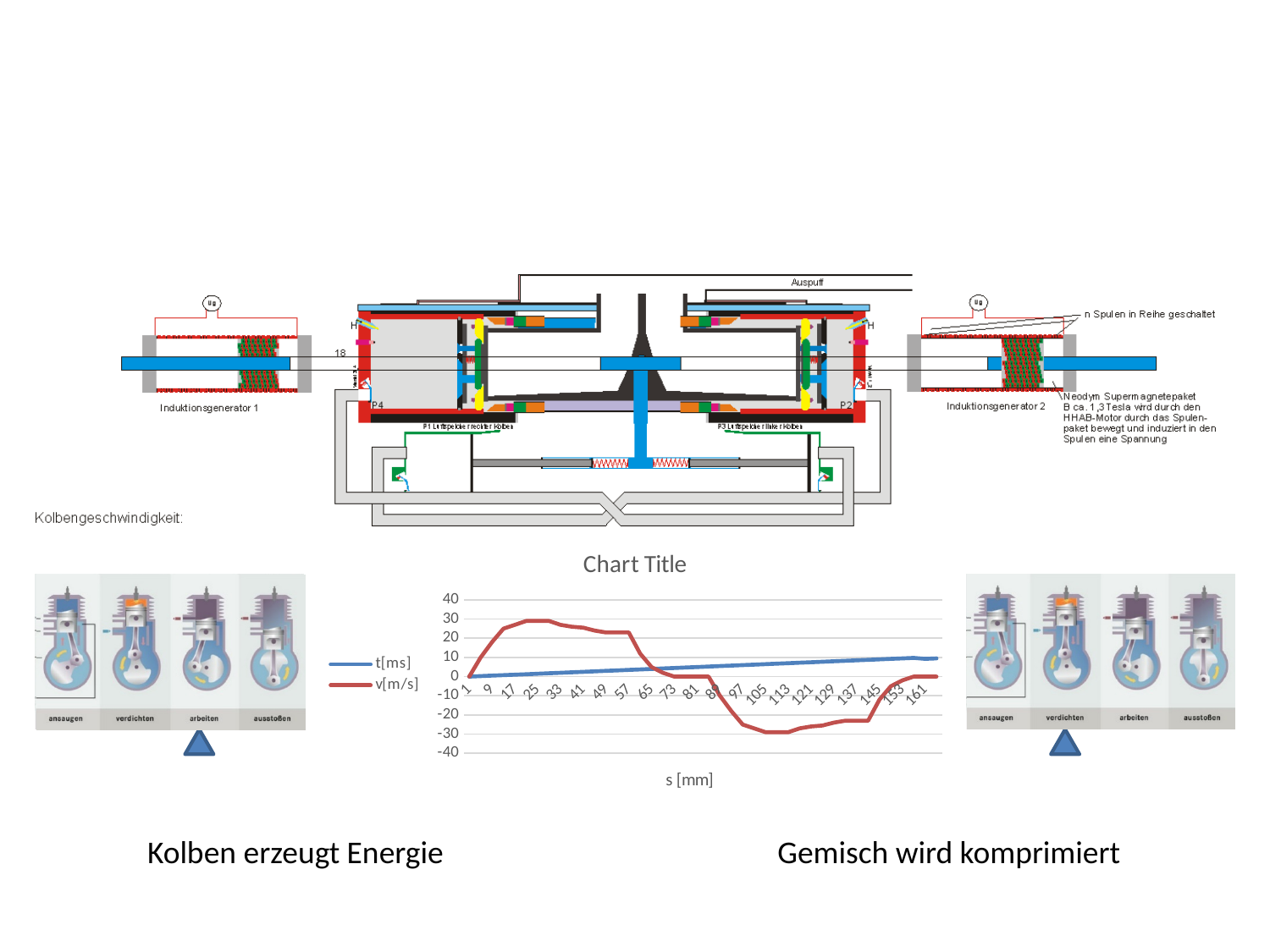
Which series reaches the highest value on the chart, t[ms] or v[m/s]? v[m/s] What are the two series named in the chart legend? t[ms] and v[m/s] How many tick labels are shown on the x axis of the chart? 21 What is the label of the x axis of the chart? s [mm] How many series does the legend of the chart list? 2 Which series reaches the lowest value on the chart, t[ms] or v[m/s]? v[m/s] Is the value of v[m/s] at s = 25 greater or less than 20? greater Does the t[ms] series rise or fall as s increases along the x axis? rise Which is larger, the value of v[m/s] at s = 25 or at s = 113? at s = 25 Is the value of t[ms] at s = 161 greater or less than 20? less Is the value of v[m/s] at s = 113 greater or less than -20? less What kind of chart is shown under "Chart Title"? line chart